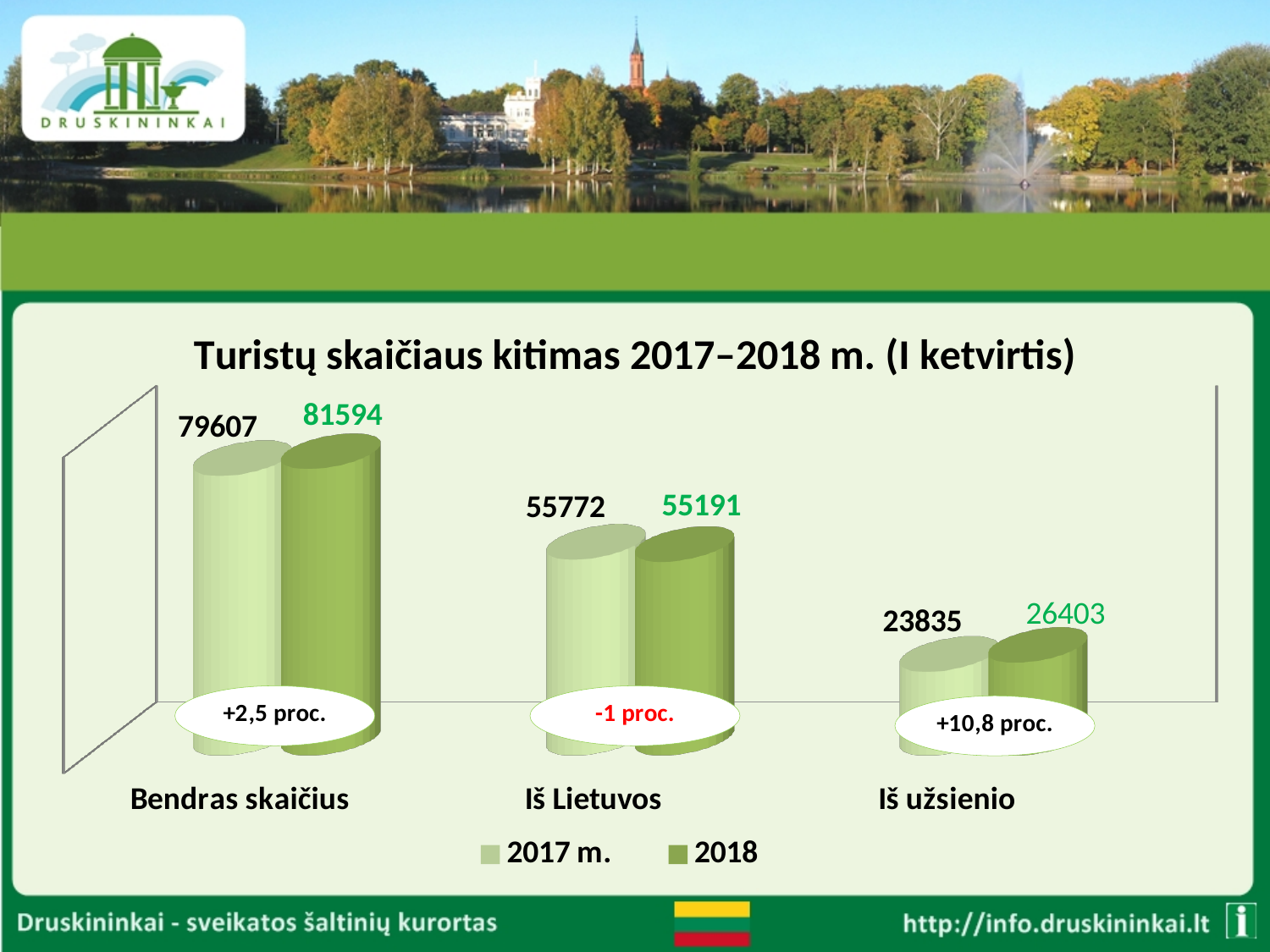
Which category has the highest value for 2018? Bendras skaičius What is the value for 2018 in the Iš užsienio category? 26403 How many categories are shown on the x axis? 3 What is the difference between the 2018 and 2017 m. values in the Bendras skaičius category? 1987 In the Iš Lietuvos category, which is larger: the 2017 m. value or the 2018 value? 2017 m. How many series does the legend list? 2 What is the value for 2017 m. in the Iš užsienio category? 23835 What percentage change label is shown for the Iš užsienio category? +10,8 proc. Which category has the lowest value for 2017 m.? Iš užsienio What is the difference between the 2018 and 2017 m. values in the Iš užsienio category? 2568 What is the value for 2017 m. in the Bendras skaičius category? 79607 What is the value for 2018 in the Iš Lietuvos category? 55191